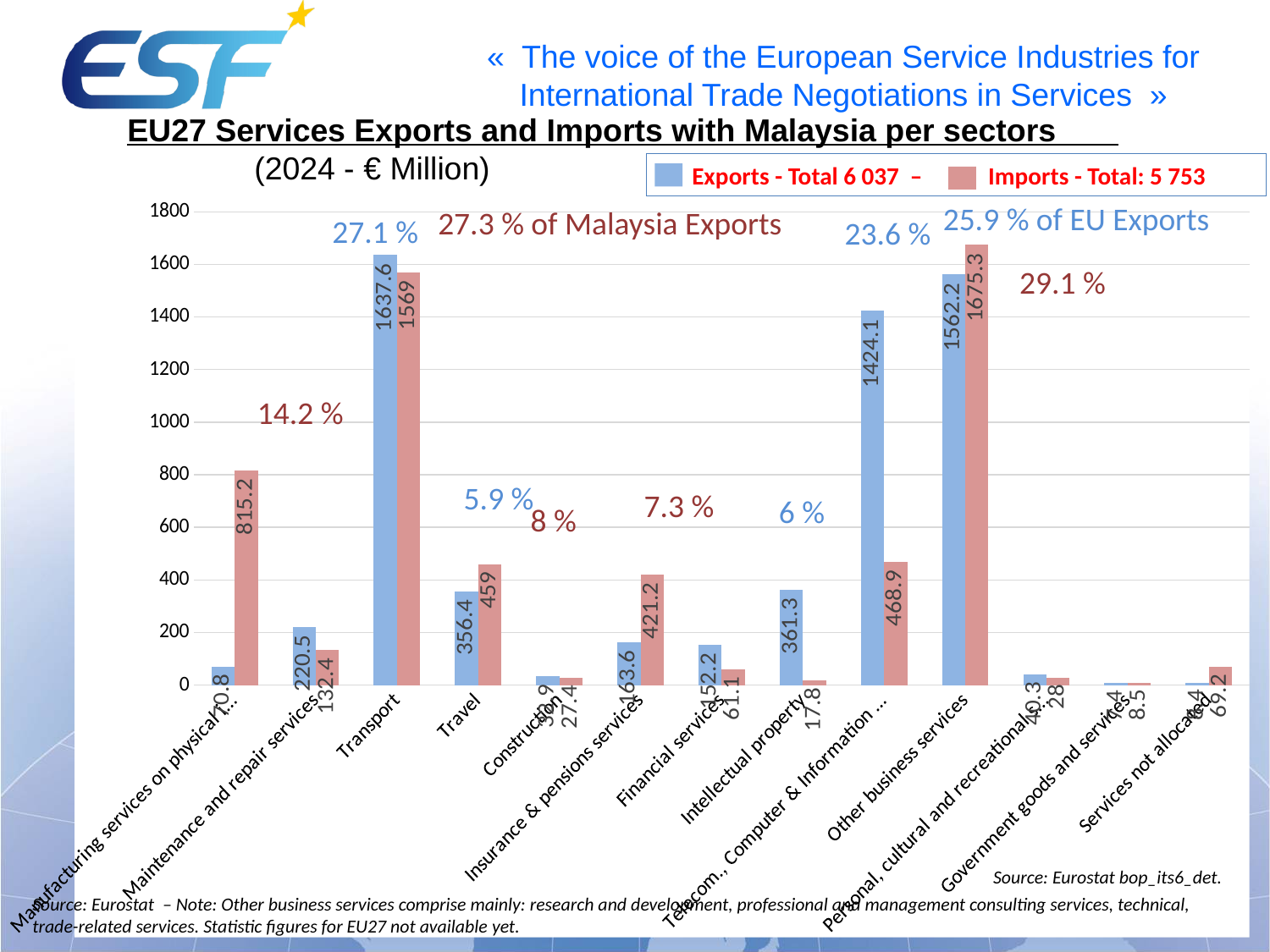
Is the imports value for Manufacturing services on physical inputs greater or less than 800? greater What is the difference between exports and imports for Transport? 68.6 What is the exports value for Telecom., Computer & Information services? 1424.1 What is the value of EU27 services exports to Malaysia for Transport? 1637.6 For Insurance & pensions services, which is larger: exports or imports? Imports What kind of chart is shown on the slide? Bar chart What is the value of imports for Other business services? 1675.3 How many series does the legend list? 2 According to the legend, what is the total of exports? 6 037 What is the imports value for Intellectual property? 17.8 Which sector has the highest imports value? Other business services Which sector has the highest exports value? Transport